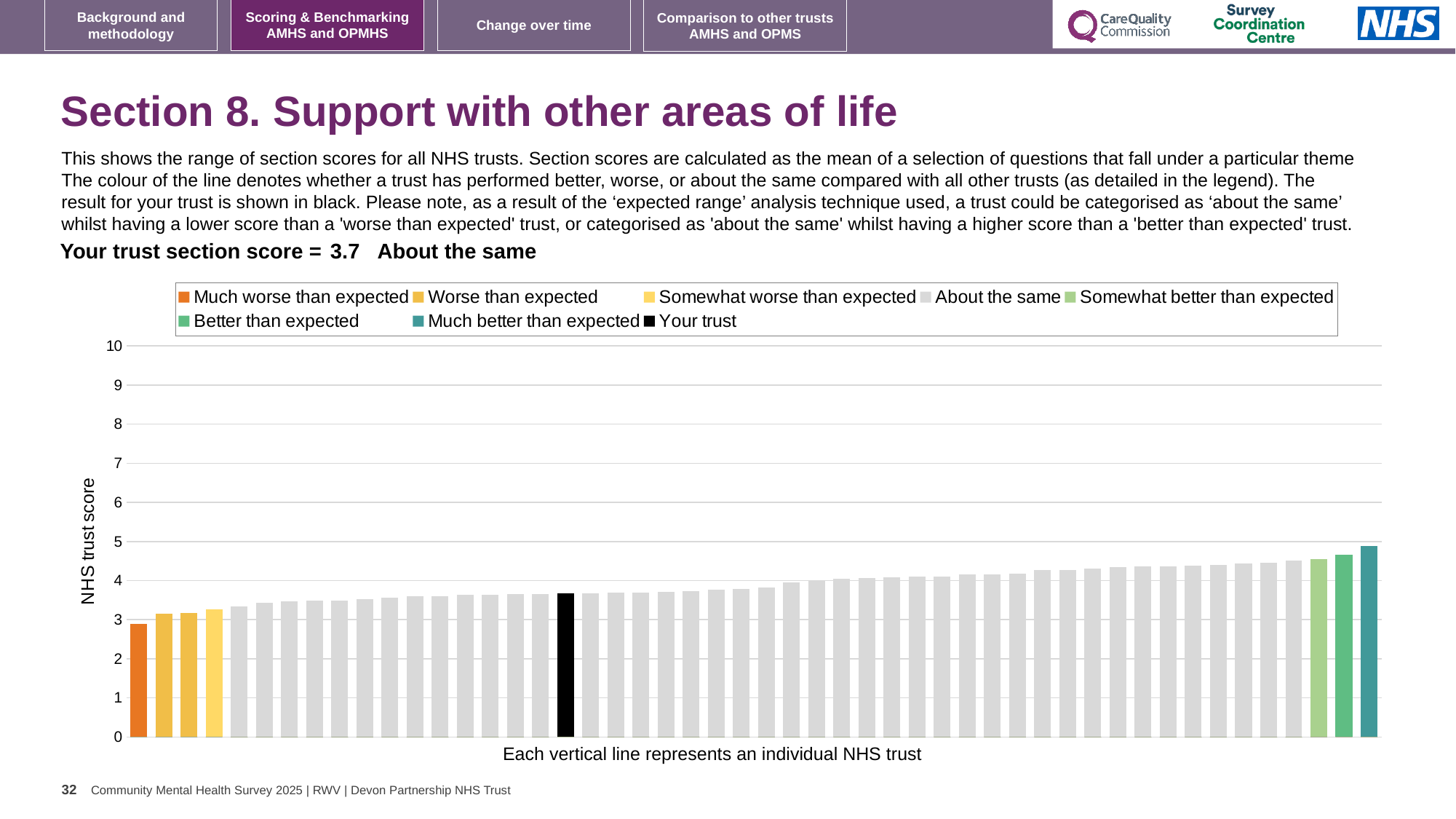
What kind of chart is shown on the slide? bar chart How many entries does the chart legend list? 8 Is the value of the tallest bar (Much better than expected) greater or less than 4? greater Which legend category does the highest bar belong to? Much better than expected What is the section score for your trust? 3.7 Is the value for your trust greater or less than 4? less Which category is your trust placed in for this section? About the same Which legend category does the lowest bar belong to? Much worse than expected Do the bar values rise or fall from left to right along the x axis? rise Is the value for your trust greater or less than 3? greater What is the title of the y axis? NHS trust score